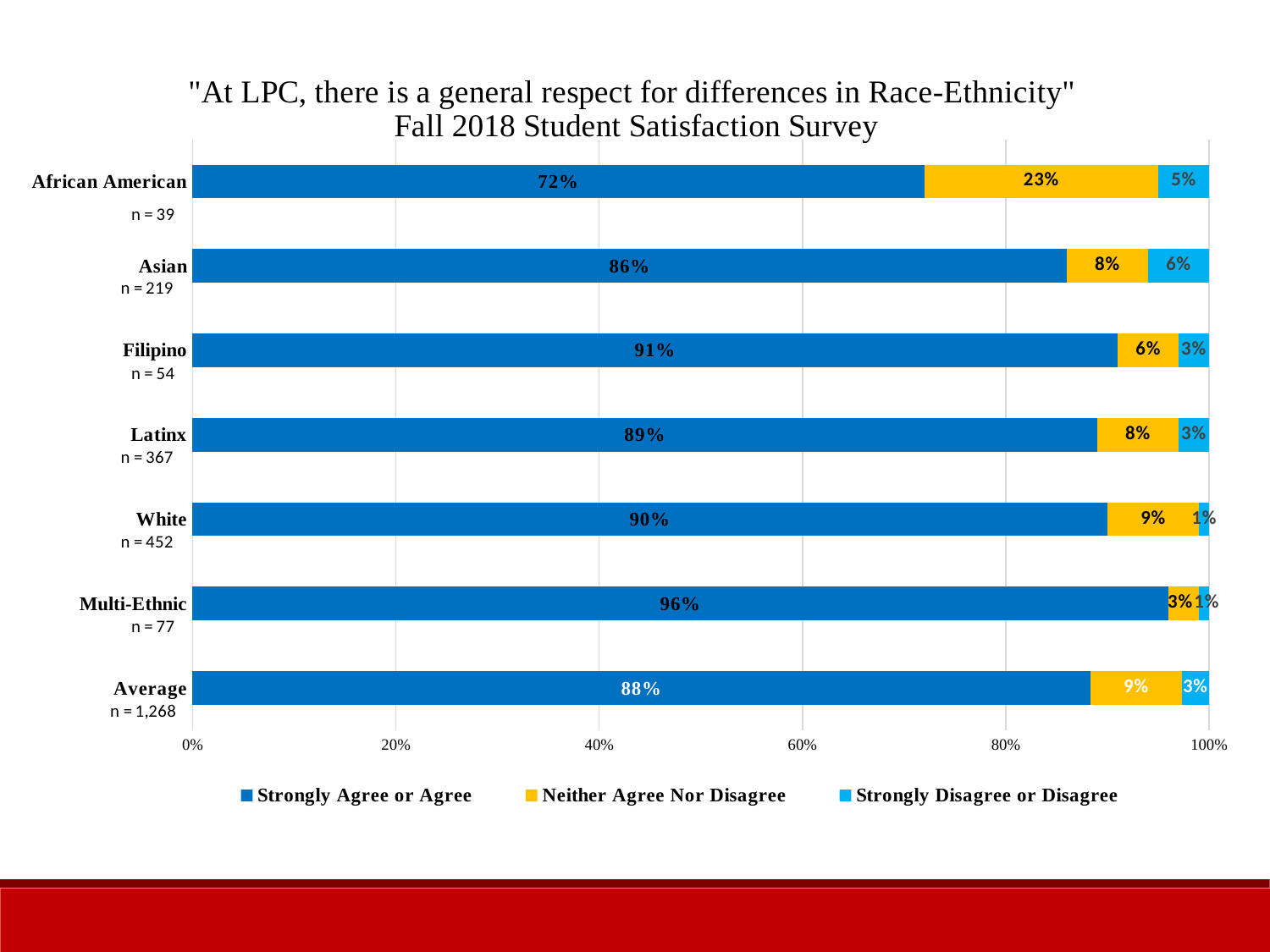
Which group has the highest Strongly Agree or Agree percentage? Multi-Ethnic Which group has a larger Neither Agree Nor Disagree share, African American or White? African American What is the sample size (n) for the Latinx group? 367 What is the difference between the Strongly Agree or Agree percentages for Multi-Ethnic and African American students? 24% Which group has the lowest Strongly Agree or Agree percentage? African American What is the Neither Agree Nor Disagree value for Asian students? 8% What is the Strongly Disagree or Disagree value for Filipino students? 3% How many series does the legend list? 3 What kind of chart is shown on the slide? Stacked bar chart What is the Strongly Agree or Agree percentage for the Average row? 88% What percentage of African American students responded Strongly Agree or Agree? 72% How many groups (bars) are shown on the chart? 7